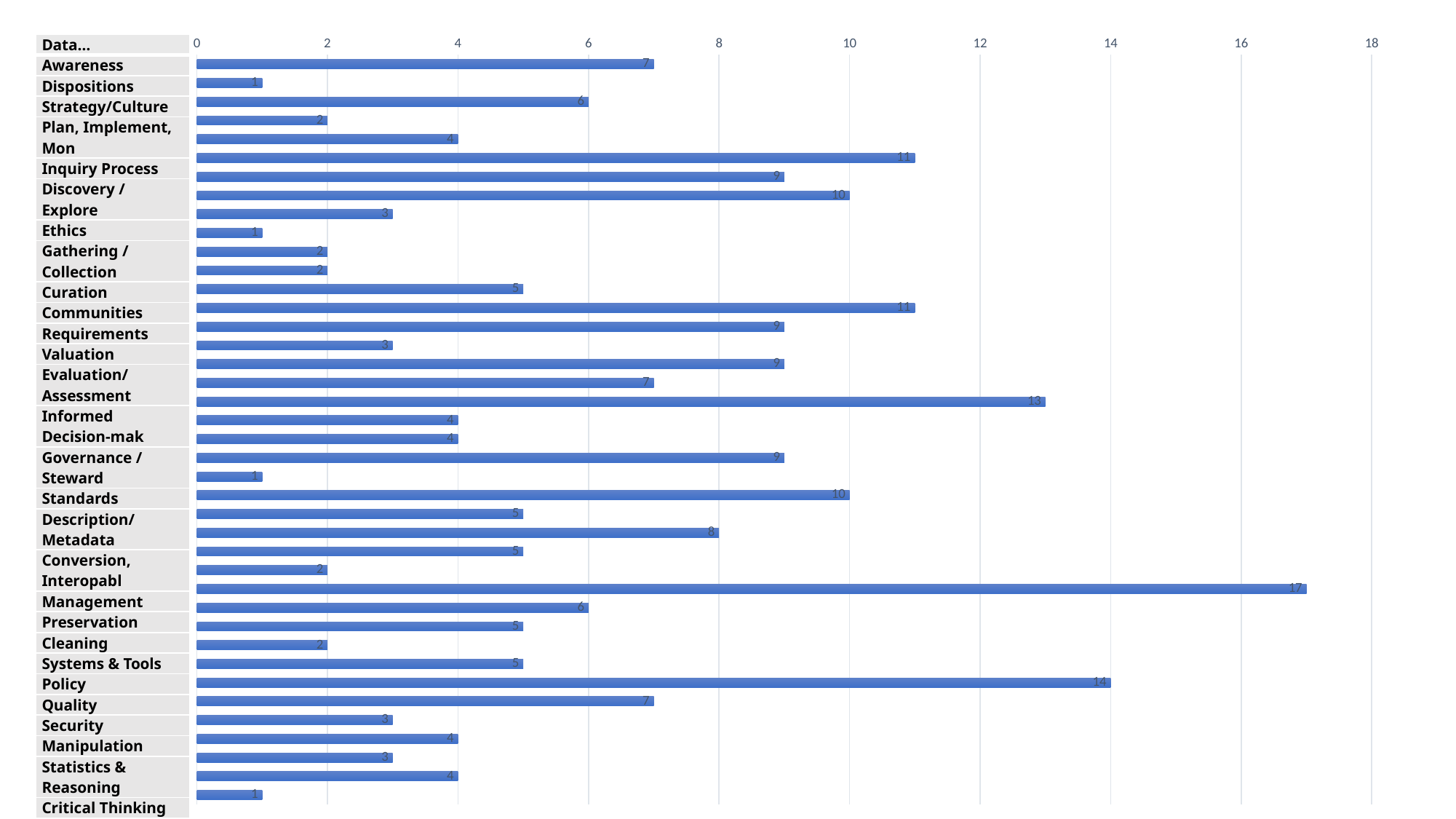
What is the value of the bar for Awareness? 7 Which has the larger value, Awareness or Dispositions? Awareness What is the largest value labelled on any bar in the chart? 17 What is the difference between the values for Awareness and Strategy/Culture? 1 What is the value of the bar for Strategy/Culture? 6 What colour are the bars in the chart? blue What is the highest tick value shown on the horizontal axis? 18 How many bars are plotted in the chart? 40 What is the smallest value labelled on any bar in the chart? 1 What is the value of the bar for Dispositions? 1 What kind of chart is shown on the slide? bar chart What is the second-largest value labelled on a bar in the chart? 14